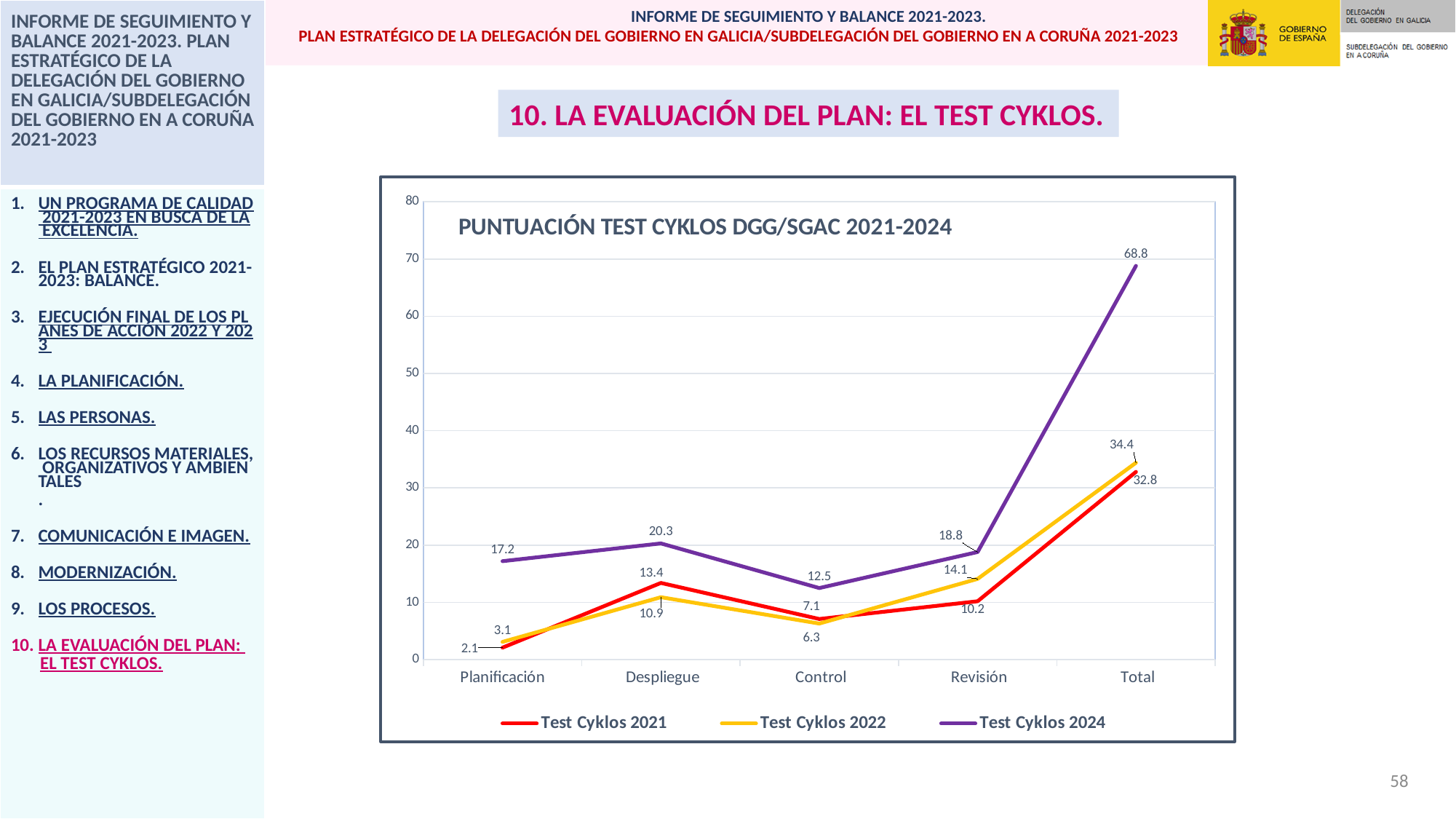
How many series does the legend list? 3 What is the Test Cyklos 2024 value for Control? 12.5 What is the difference between the Test Cyklos 2024 and Test Cyklos 2021 values for Total? 36 What is the Test Cyklos 2022 value for Revisión? 14.1 What is the Test Cyklos 2021 value for Despliegue? 13.4 How many categories are shown on the x axis? 5 Which category has the lowest Test Cyklos 2021 value? Planificación Excluding Total, which category has the highest Test Cyklos 2024 value? Despliegue Is the Test Cyklos 2024 value for Total greater or less than 60? greater Which is larger for Despliegue: Test Cyklos 2021 or Test Cyklos 2022? Test Cyklos 2021 What kind of chart is shown on the slide? Line chart What is the Test Cyklos 2024 value for Total? 68.8